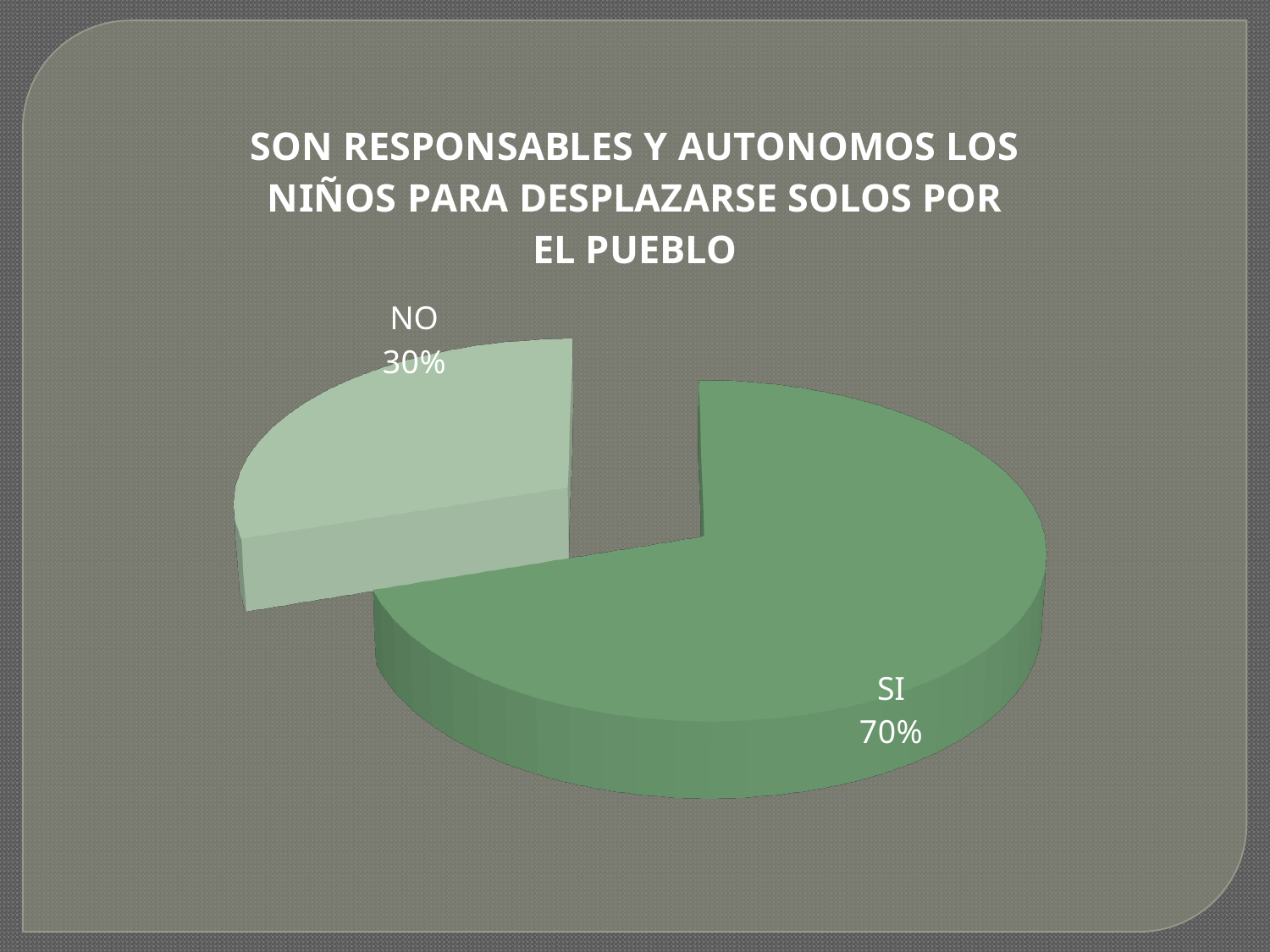
How many slices does the pie chart have? 2 What percentage is shown for the NO slice? 30% What is the title of the chart? SON RESPONSABLES Y AUTONOMOS LOS NIÑOS PARA DESPLAZARSE SOLOS POR EL PUEBLO Which slice is the smallest? NO What share of the pie does the NO slice represent? 30% Which is larger, the SI slice or the NO slice? SI Which slice is the largest? SI What percentage is shown for the SI slice? 70% What type of chart is shown on the slide? Pie chart Which slice is pulled out (exploded) from the pie? NO What is the difference in percentage points between the SI and NO slices? 40